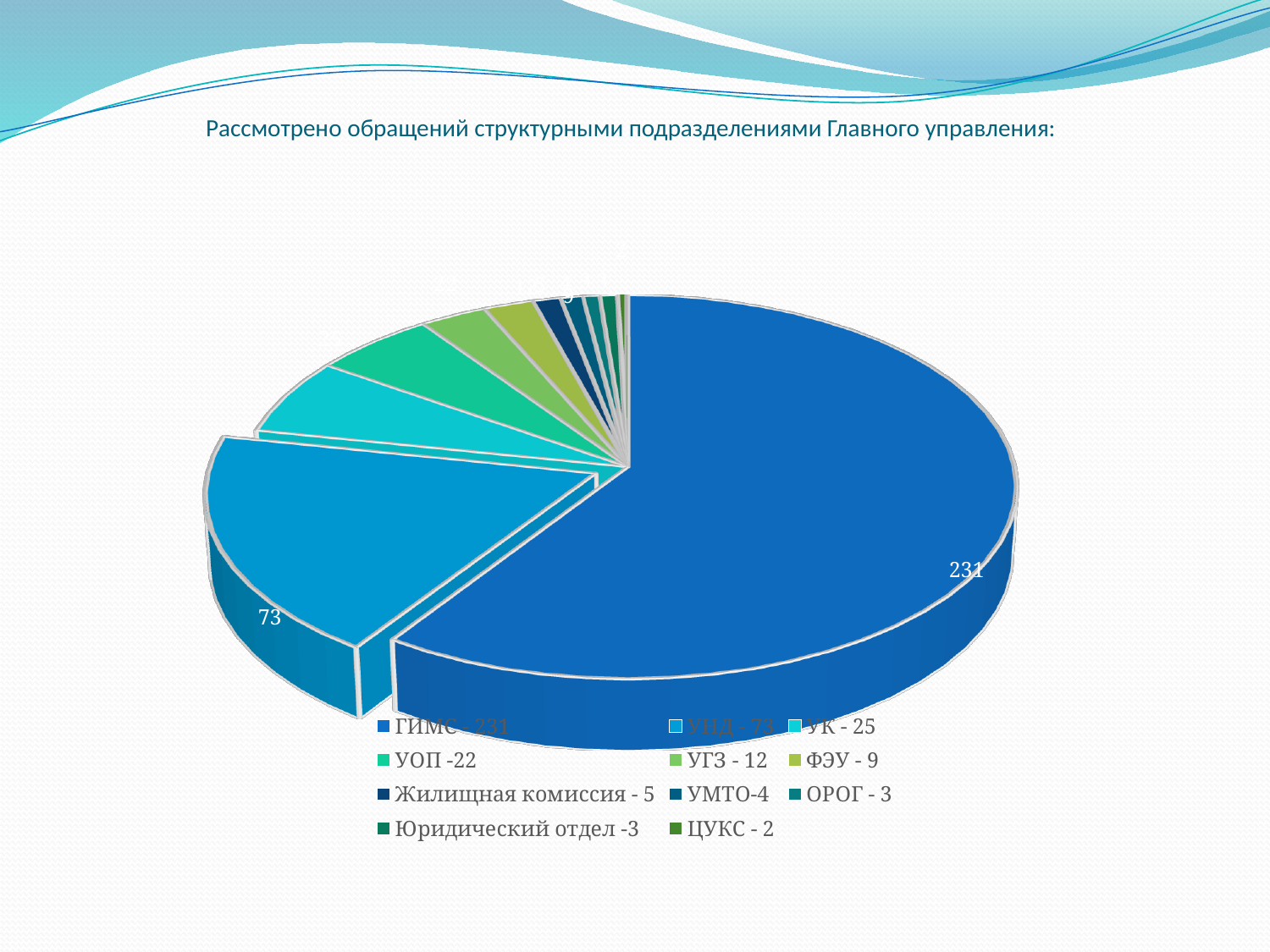
What kind of chart is shown on the slide? pie chart How many categories does the pie chart have? 11 What is the title of the chart? Рассмотрено обращений структурными подразделениями Главного управления: What is the total of all values shown in the legend? 389 Which is larger, the value for УК or the value for УОП? УК Which division has the smallest value? ЦУКС What is the value for ЦУКС? 2 Which division has the largest slice of the pie? ГИМС How many appeals were reviewed by ГИМС? 231 What is the value for Жилищная комиссия? 5